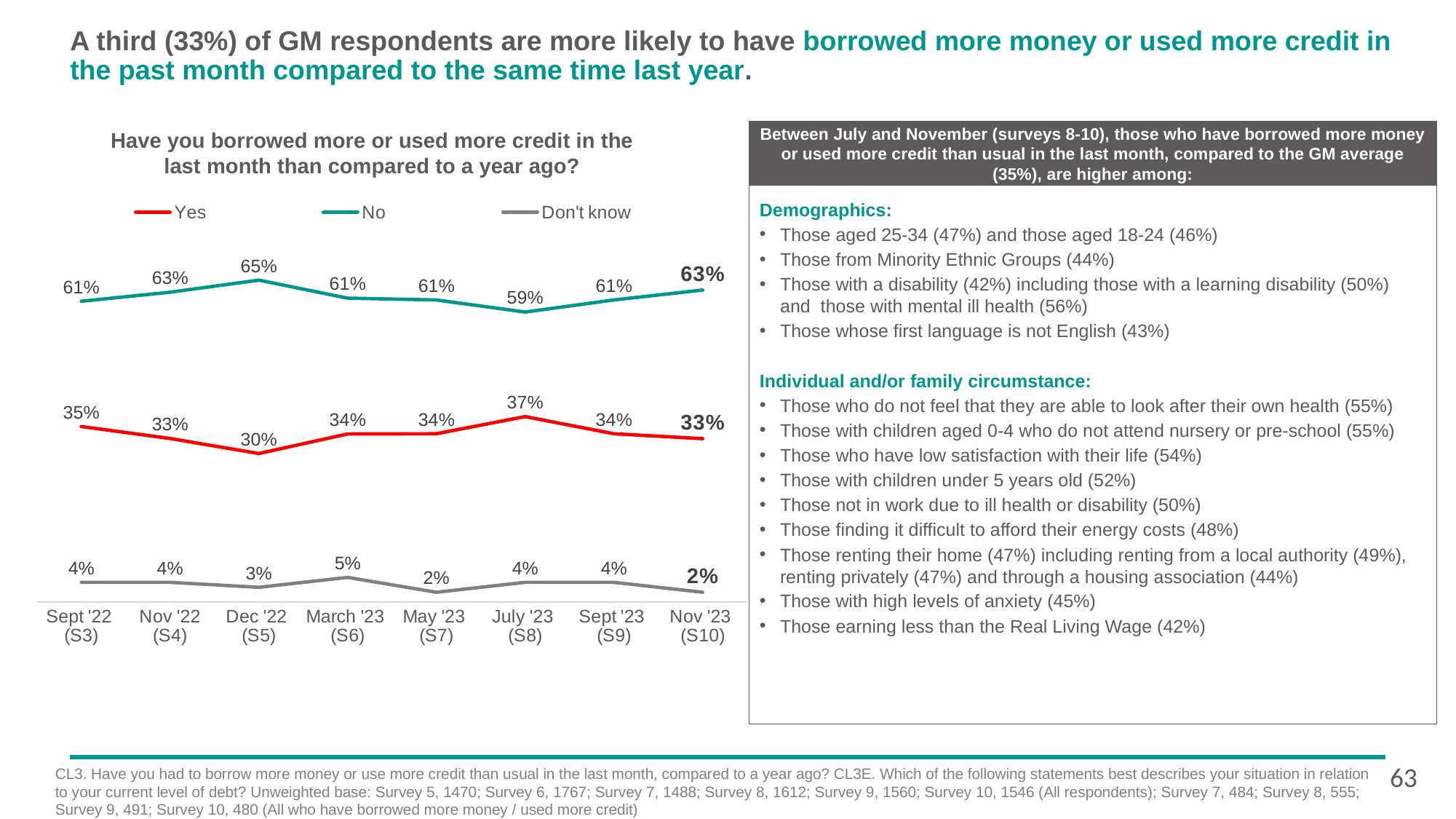
Which is larger: the 'Yes' value in Sept '22 (S3) or the 'Yes' value in Dec '22 (S5)? Sept '22 (S3) In which survey wave did the 'Yes' series reach its highest value? July '23 (S8) What is the difference between the 'No' and 'Yes' values in Nov '23 (S10)? 30 percentage points How many series does the legend list? 3 What percentage of respondents answered 'Don't know' in March '23 (S6)? 5% What kind of chart is used to show the survey responses? Line chart Which colour is used for the 'Yes' line in the chart? Red In which survey wave did the 'No' series reach its lowest value? July '23 (S8) What percentage of respondents answered 'No' in Dec '22 (S5)? 65% Did the 'Yes' series rise or fall between July '23 (S8) and Nov '23 (S10)? Fall What percentage of respondents answered 'Yes' in Nov '23 (S10)? 33% How many survey waves are shown on the x axis? 8